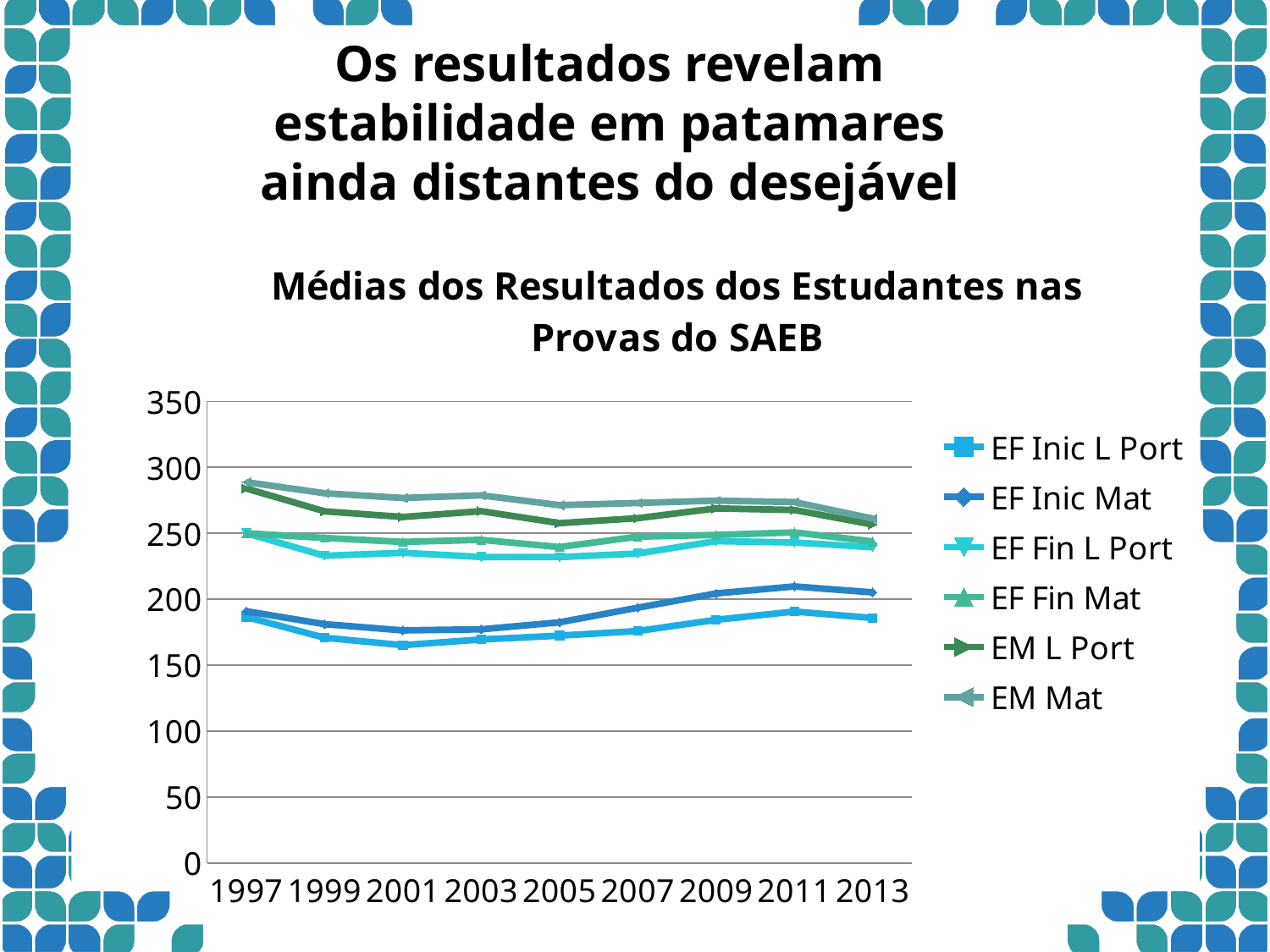
Is the value for EF Inic Mat in 2011 greater or less than 200? greater In 2011, which is higher: EF Inic Mat or EF Inic L Port? EF Inic Mat How many years are shown on the x axis? 9 Does EF Inic Mat rise or fall between 2001 and 2011? rise Is the value for EM Mat in 1997 greater or less than 250? greater How many series does the legend list? 6 Is the value for EF Inic L Port in 2001 greater or less than 200? less In which year is EM L Port at its highest? 1997 Which series is listed last in the legend? EM Mat What kind of chart is shown on the slide? line chart What is the title of the chart? Médias dos Resultados dos Estudantes nas Provas do SAEB Which series has the lowest value in 2001? EF Inic L Port